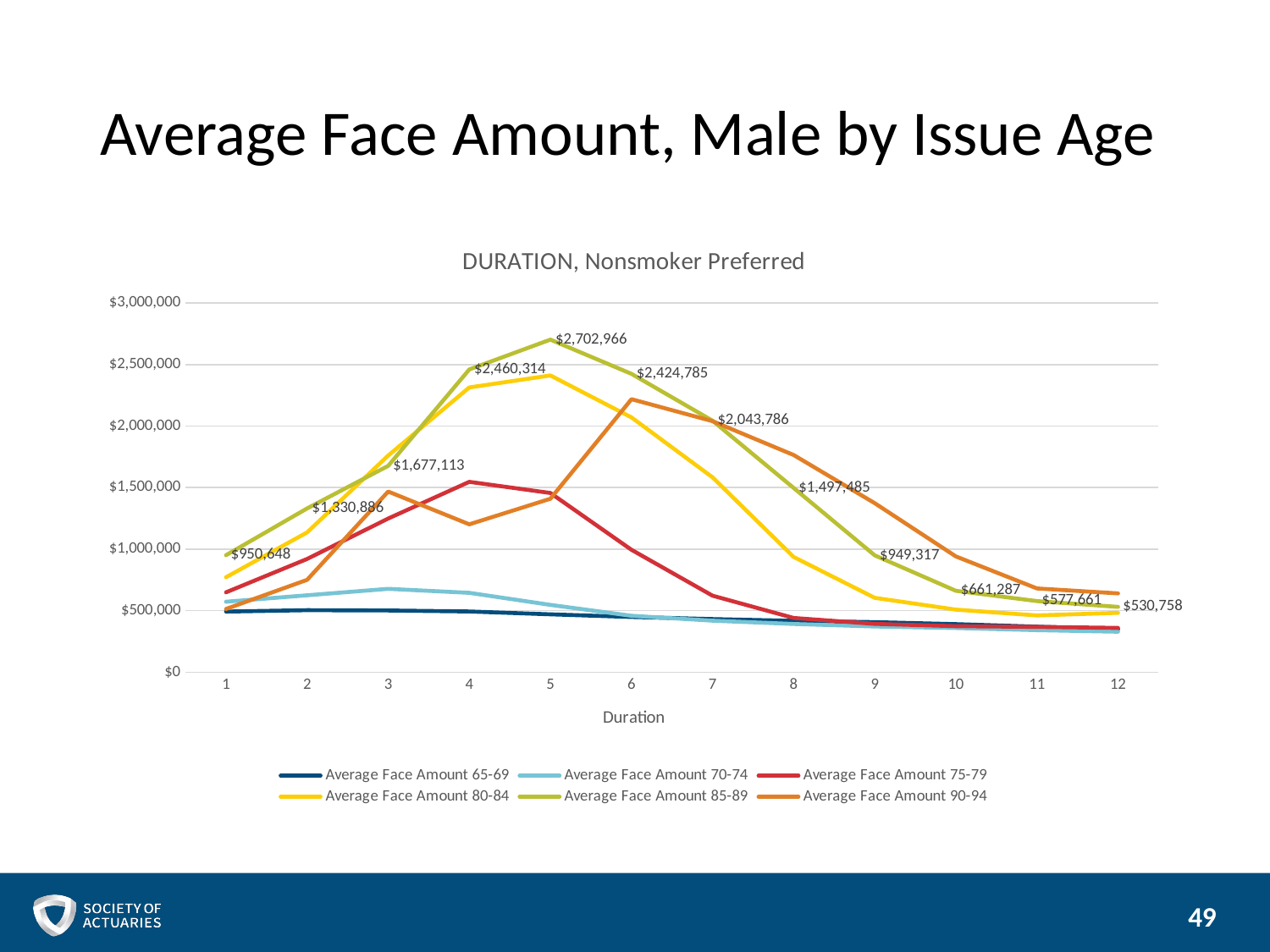
What is the labelled value for Average Face Amount 85-89 at duration 1? $950,648 What is the labelled value for Average Face Amount 85-89 at duration 5? $2,702,966 Which is larger for Average Face Amount 85-89: the value at duration 4 or at duration 7? duration 4 What is the title shown above the plot area? DURATION, Nonsmoker Preferred How many series does the legend list? 6 What is the difference between the Average Face Amount 85-89 values at duration 5 and duration 6? $278,181 How many duration points are plotted along the x axis? 12 Is the value for Average Face Amount 90-94 at duration 6 greater or less than $2,000,000? greater At which duration does the Average Face Amount 85-89 series reach its highest value? 5 What is the labelled value for Average Face Amount 85-89 at duration 12? $530,758 What type of chart is shown on the slide? line chart At which duration is the Average Face Amount 85-89 series lowest? 12